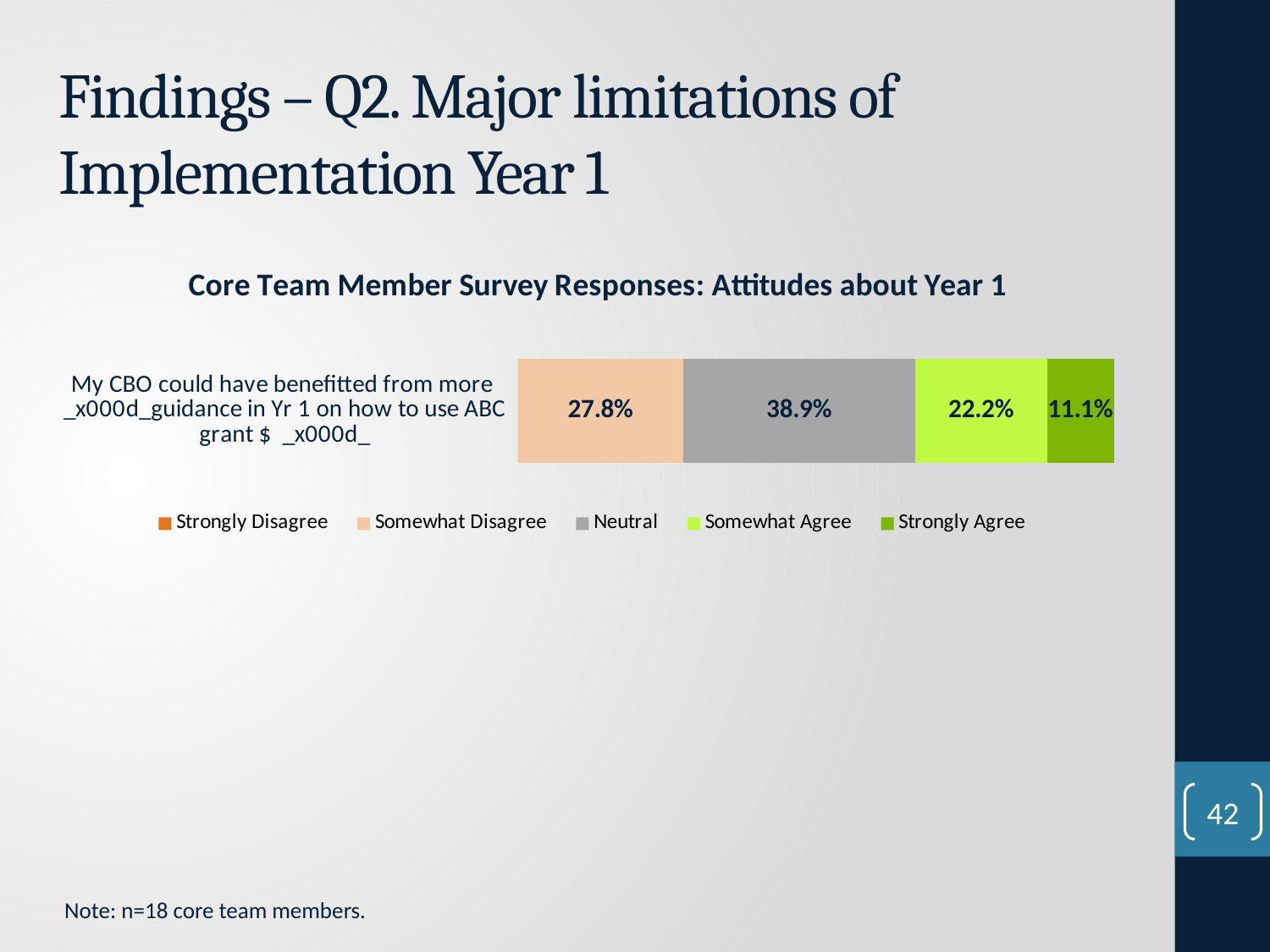
What is the difference between the Neutral share and the Somewhat Disagree share? 11.1% What kind of chart is shown on the slide? Stacked bar chart How many response categories does the legend list? 5 What percentage of core team members responded Somewhat Agree? 22.2% Among the response categories with a visible segment, which has the smallest share? Strongly Agree What is the title of the chart? Core Team Member Survey Responses: Attitudes about Year 1 What percentage of core team members responded Somewhat Disagree? 27.8% Which is larger, the Somewhat Agree share or the Strongly Agree share? Somewhat Agree Which response category has the largest share of the bar? Neutral What percentage of core team members responded Strongly Agree? 11.1% What is the combined share of Somewhat Agree and Strongly Agree responses? 33.3% What percentage of core team members responded Neutral to the statement about needing more guidance in Year 1? 38.9%